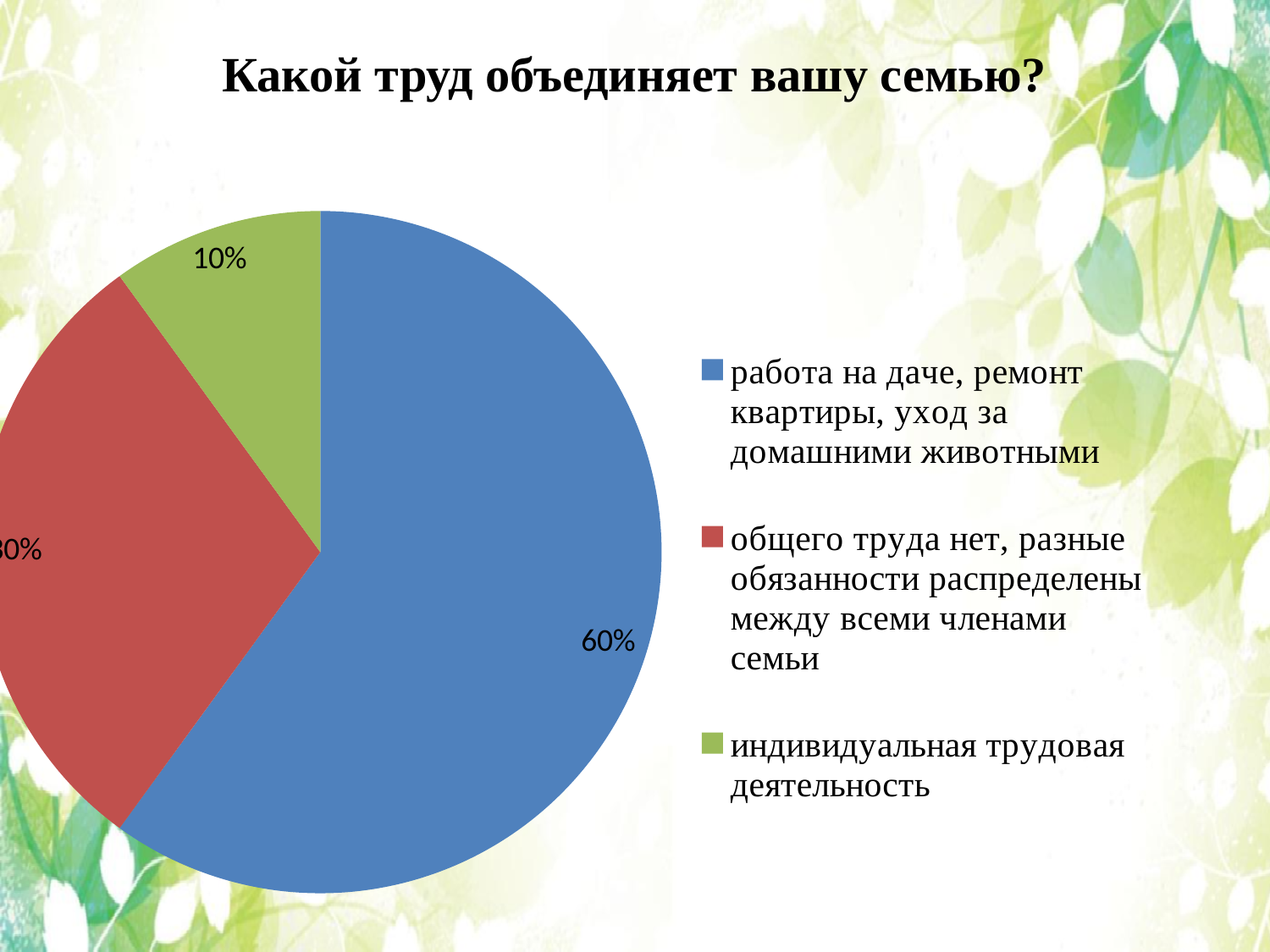
How many entries does the legend list? 3 Which category has the smallest slice of the pie? индивидуальная трудовая деятельность Is the share for "индивидуальная трудовая деятельность" greater or less than 50%? less What kind of chart is shown on the slide? pie chart How many slices does the pie chart have? 3 What is the difference in percentage points between the 60% slice and the 10% slice? 50% What colour is the slice for "индивидуальная трудовая деятельность"? green Which is larger: the slice for "работа на даче, ремонт квартиры, уход за домашними животными" or the slice for "общего труда нет, разные обязанности распределены между всеми членами семьи"? работа на даче, ремонт квартиры, уход за домашними животными What is the title of the chart on the slide? Какой труд объединяет вашу семью? What share of the pie is labelled for "индивидуальная трудовая деятельность"? 10% What share of the pie is labelled for "работа на даче, ремонт квартиры, уход за домашними животными"? 60% Which category has the largest slice of the pie? работа на даче, ремонт квартиры, уход за домашними животными